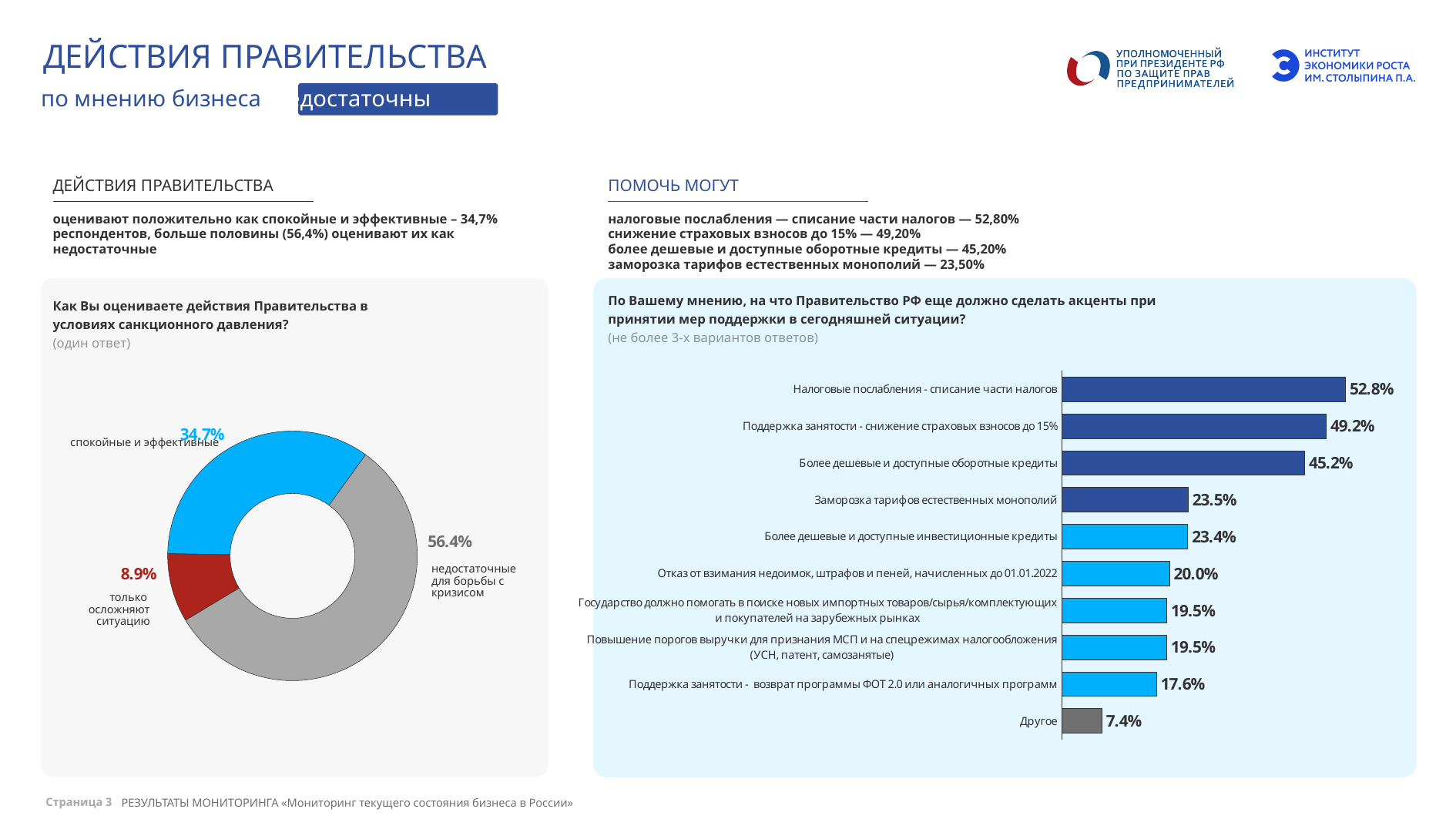
How many categories are shown in the right bar chart? 10 What kind of chart is the right chart on the slide? Bar chart In the left donut chart, which answer has the smallest share? только осложняют ситуацию In the right bar chart, what is the difference between 'Налоговые послабления - списание части налогов' and 'Поддержка занятости - снижение страховых взносов до 15%'? 3.6% In the left donut chart, what share of respondents consider the government's actions 'спокойные и эффективные'? 34.7% What kind of chart is the left chart on the slide? Donut (pie) chart In the right bar chart, which category has the lowest value? Другое In the right bar chart, what is the value for 'Заморозка тарифов естественных монополий'? 23.5% In the left donut chart, what share of respondents consider the government's actions 'недостаточные для борьбы с кризисом'? 56.4% In the right bar chart, which category has the highest value? Налоговые послабления - списание части налогов In the right bar chart, which is larger: 'Более дешевые и доступные оборотные кредиты' or 'Более дешевые и доступные инвестиционные кредиты'? Более дешевые и доступные оборотные кредиты In the left donut chart, what is the difference between the 'недостаточные для борьбы с кризисом' share and the 'спокойные и эффективные' share? 21.7%